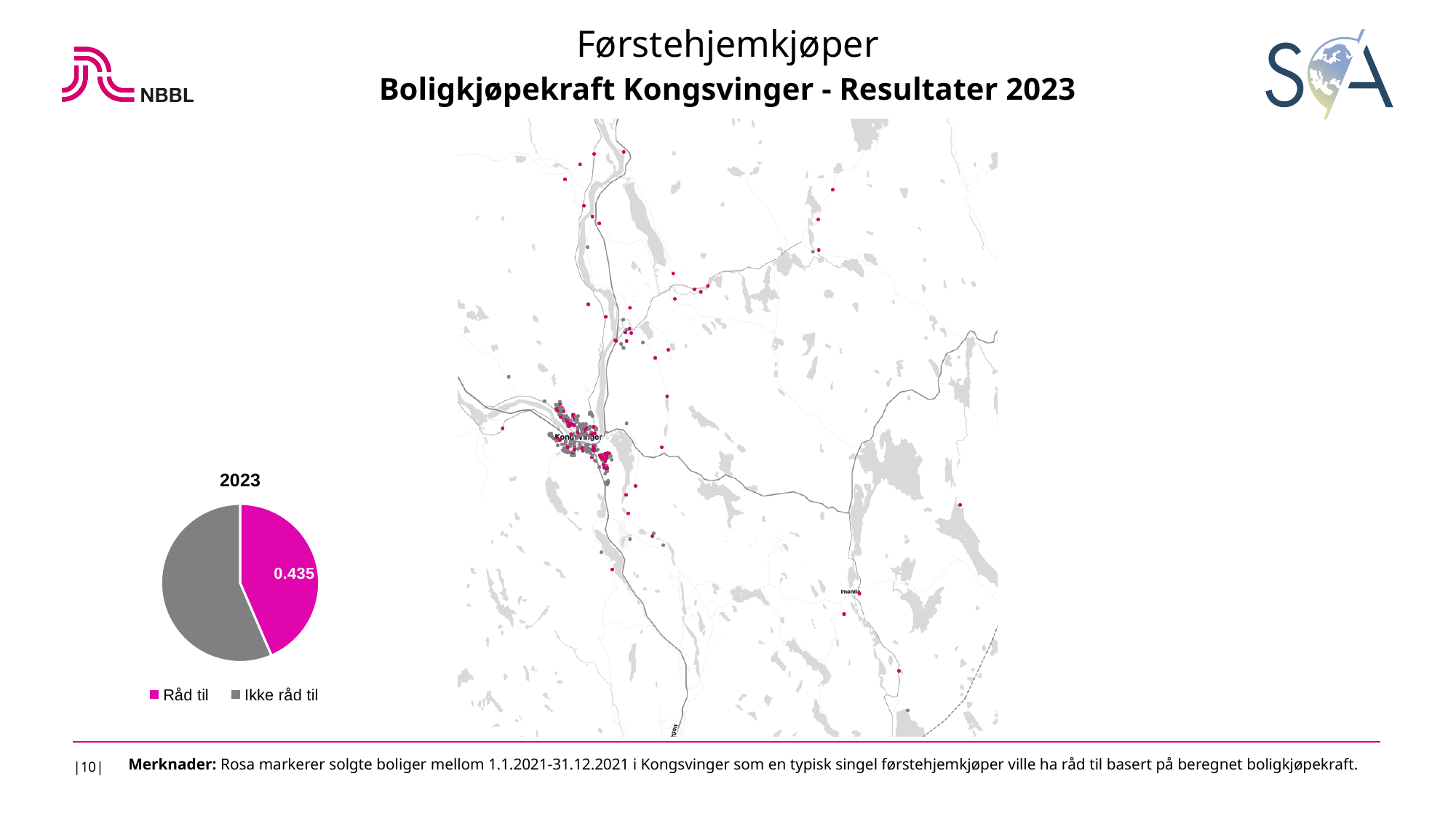
In the pie chart, which slice is larger: 'Råd til' or 'Ikke råd til'? Ikke råd til What is the title of the pie chart? 2023 Which category has the largest slice in the pie chart? Ikke råd til What kind of chart is shown on the left of the slide? pie chart What value is labelled on the 'Råd til' slice of the pie chart? 0.435 What share of the pie chart does the 'Råd til' slice represent? 0.435 Which category has the smallest slice in the pie chart? Råd til How many entries does the pie chart legend list? 2 What colour is the 'Råd til' slice in the pie chart? pink How many categories does the pie chart have? 2